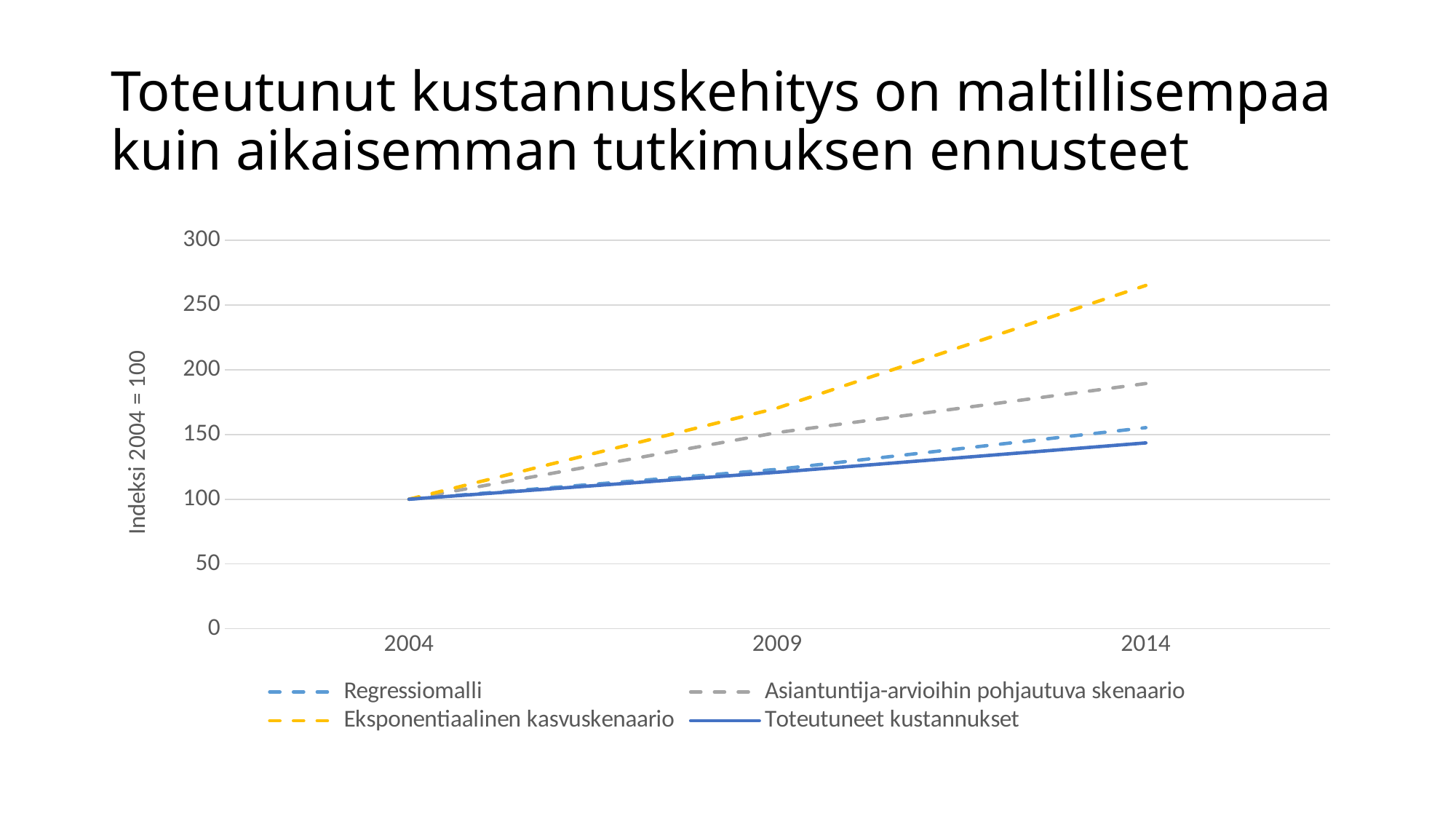
Which series has the highest value in 2014? Eksponentiaalinen kasvuskenaario What is the value of Toteutuneet kustannukset in 2004? 100 Is the value for Toteutuneet kustannukset in 2014 greater or less than 150? less How many series does the legend list? 4 Do the values of Eksponentiaalinen kasvuskenaario rise or fall from 2004 to 2014? rise What kind of chart is shown on the slide? line chart What is the label of the vertical axis? Indeksi 2004 = 100 In 2014, which is larger: Asiantuntija-arvioihin pohjautuva skenaario or Regressiomalli? Asiantuntija-arvioihin pohjautuva skenaario Is the value for Eksponentiaalinen kasvuskenaario in 2014 greater or less than 250? greater How many years are marked on the x axis? 3 Is the value for Asiantuntija-arvioihin pohjautuva skenaario in 2014 greater or less than 200? less Which series has the lowest value in 2014? Toteutuneet kustannukset